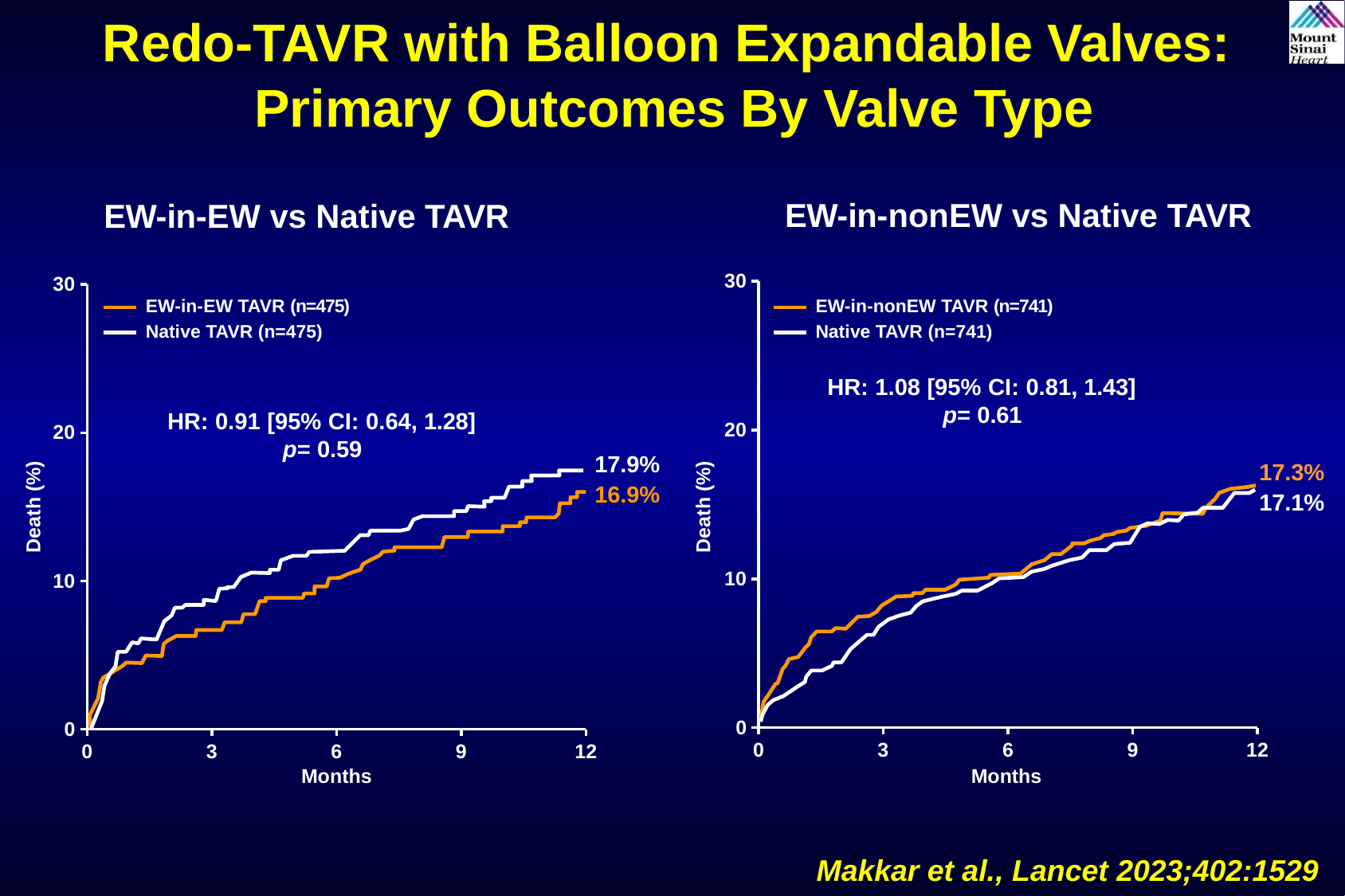
What hazard ratio is shown on the EW-in-nonEW vs Native TAVR chart? 1.08 [95% CI: 0.81, 1.43] In the EW-in-EW vs Native TAVR chart, what is the difference between the 12-month death rates of Native TAVR and EW-in-EW TAVR? 1.0% In the EW-in-EW vs Native TAVR chart, do the death rates rise or fall over the months? Rise How many series does the legend of the EW-in-EW vs Native TAVR chart list? 2 In the EW-in-EW vs Native TAVR chart, is the death rate for Native TAVR at 6 months greater or less than 10? greater In the EW-in-EW vs Native TAVR chart, what is the 12-month death rate for EW-in-EW TAVR? 16.9% In the EW-in-EW vs Native TAVR chart, what is the 12-month death rate for Native TAVR? 17.9% What kind of chart is the EW-in-nonEW vs Native TAVR chart? Line chart In the EW-in-nonEW vs Native TAVR chart, is the death rate for EW-in-nonEW TAVR at 3 months greater or less than 10? less In the EW-in-nonEW vs Native TAVR chart, which group has the higher 12-month death rate, EW-in-nonEW TAVR or Native TAVR? EW-in-nonEW TAVR In the EW-in-nonEW vs Native TAVR chart, what is the 12-month death rate for EW-in-nonEW TAVR? 17.3% In the EW-in-nonEW vs Native TAVR chart, what is the 12-month death rate for Native TAVR? 17.1%